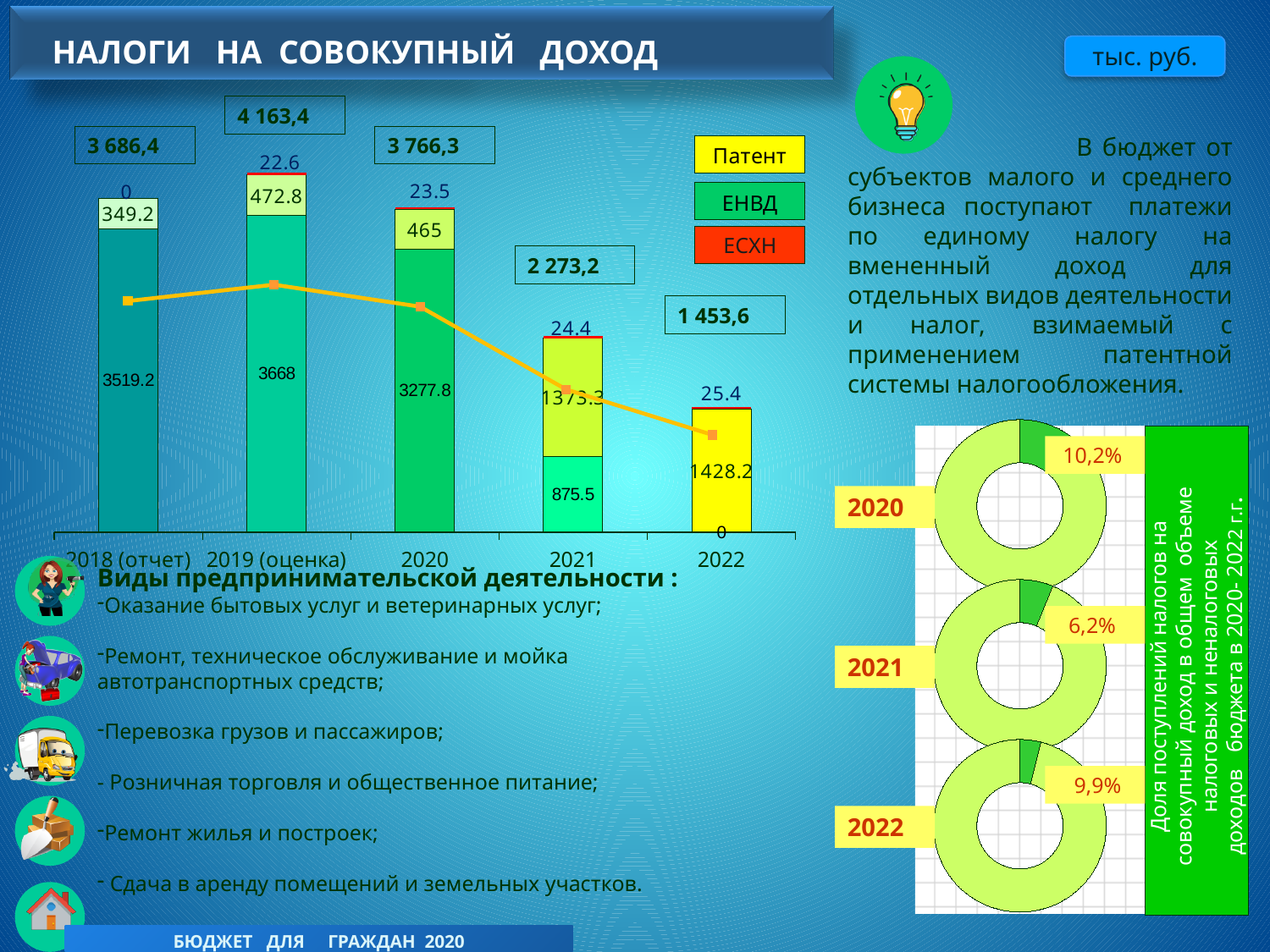
In the chart 'НАЛОГИ НА СОВОКУПНЫЙ ДОХОД', which year has the highest total shown? 2019 (оценка) What kind of chart is the main chart titled 'НАЛОГИ НА СОВОКУПНЫЙ ДОХОД'? bar chart In the chart 'НАЛОГИ НА СОВОКУПНЫЙ ДОХОД', how many year categories are shown on the x axis? 5 In the chart 'НАЛОГИ НА СОВОКУПНЫЙ ДОХОД', what is the ЕСХН value for 2022? 25.4 In the donut charts on the right showing the share of taxes on aggregate income in total budget revenues, what is the share for 2021? 6,2% In the chart 'НАЛОГИ НА СОВОКУПНЫЙ ДОХОД', what is the difference between the ЕНВД value for 2020 and the ЕНВД value for 2021? 2402.3 In the chart 'НАЛОГИ НА СОВОКУПНЫЙ ДОХОД', what is the Патент value for 2021? 1373.3 In the chart 'НАЛОГИ НА СОВОКУПНЫЙ ДОХОД', how many series does the legend list? 3 In the chart 'НАЛОГИ НА СОВОКУПНЫЙ ДОХОД', which year has the lowest total shown? 2022 In the chart 'НАЛОГИ НА СОВОКУПНЫЙ ДОХОД', what is the ЕНВД value for 2019 (оценка)? 3668 In the chart 'НАЛОГИ НА СОВОКУПНЫЙ ДОХОД', which year has the larger Патент value, 2021 or 2022? 2022 In the chart 'НАЛОГИ НА СОВОКУПНЫЙ ДОХОД', what total is shown in the box above the 2021 bar? 2 273,2